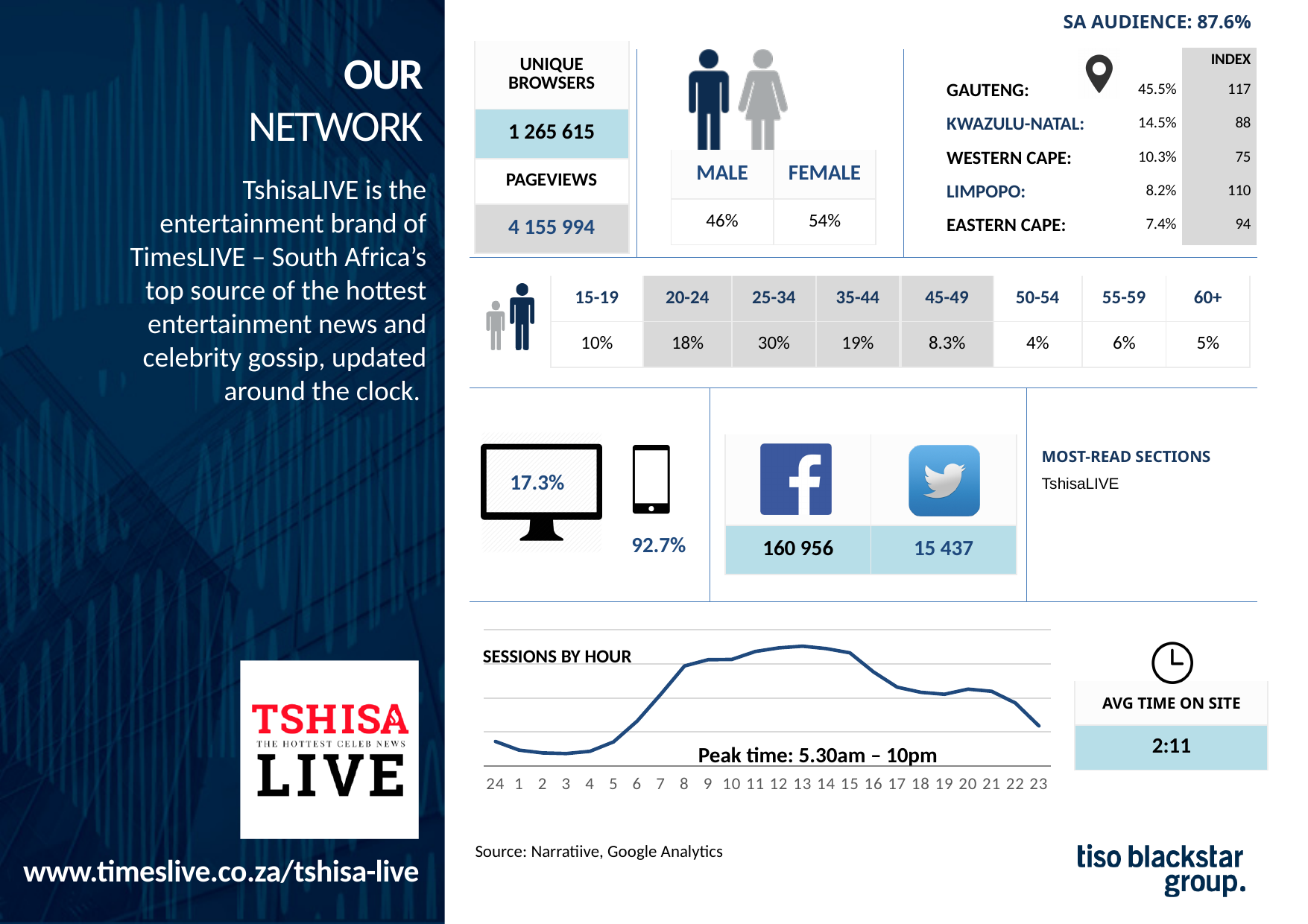
In the 'Sessions by hour' chart, is the value at hour 13 larger or smaller than the value at hour 2? larger What peak time is annotated on the 'Sessions by hour' chart? 5.30am – 10pm What is the title of the line chart at the bottom of the slide? Sessions by hour How many lines are plotted in the 'Sessions by hour' chart? 1 In the 'Sessions by hour' chart, is the value at hour 23 larger or smaller than the value at hour 10? smaller How many hour points are labelled on the x axis of the 'Sessions by hour' chart? 24 What kind of chart is the 'Sessions by hour' chart? line chart What is the first label on the x axis of the 'Sessions by hour' chart? 24 In the 'Sessions by hour' chart, which is larger: the value at hour 9 or the value at hour 3? hour 9 In the 'Sessions by hour' chart, do sessions rise or fall between hour 15 and hour 23? fall In the 'Sessions by hour' chart, do sessions rise or fall between hour 5 and hour 8? rise